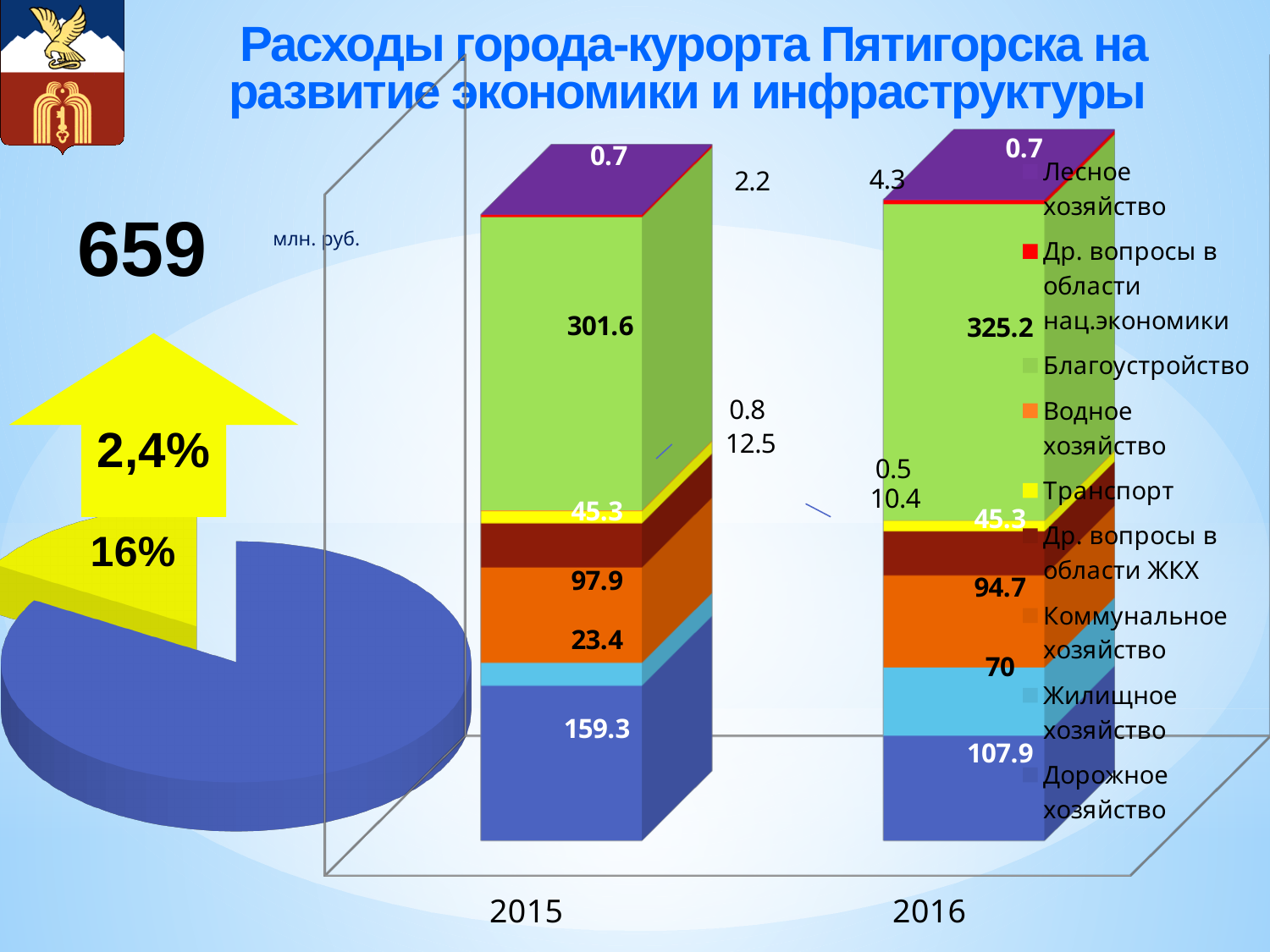
What is the value for Жилищное хозяйство in 2016? 70 How many years (categories) are shown on the x axis of the bar chart? 2 By how much did Жилищное хозяйство increase from 2015 to 2016? 46.6 What kind of chart is used to show the expenses by year? stacked bar chart What unit is indicated for the values in the bar chart? млн. руб. By how much did Дорожное хозяйство decrease from 2015 to 2016? 51.4 How many series does the legend of the bar chart list? 9 Which year has the larger value for Благоустройство, 2015 or 2016? 2016 What is the value for Благоустройство in 2015? 301.6 What is the value for Транспорт in 2015? 12.5 Which series has the largest segment in the 2015 bar? Благоустройство What is the value for Дорожное хозяйство in 2016? 107.9